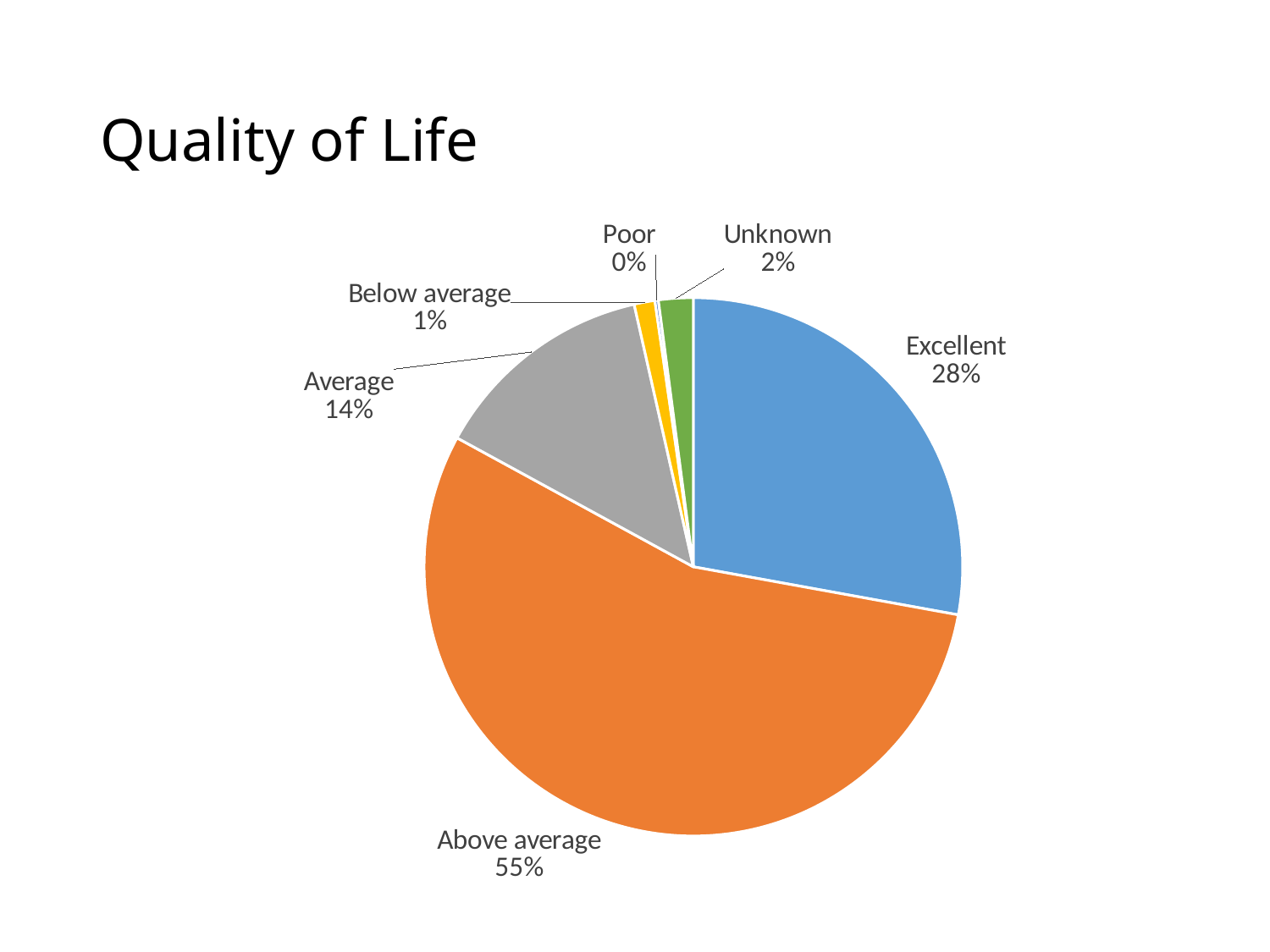
What is the value for Below average? 1% What kind of chart is shown on the slide? Pie chart What is the difference between Above average and Excellent? 27% Which category has the smallest slice? Poor What share of the pie does Above average represent? 55% What is the value for Average? 14% What is the value for Unknown? 2% How many categories are shown in the pie chart? 6 Which is larger, Excellent or Average? Excellent Which category has the largest slice? Above average What is the value for Excellent? 28% What is the title of the slide? Quality of Life